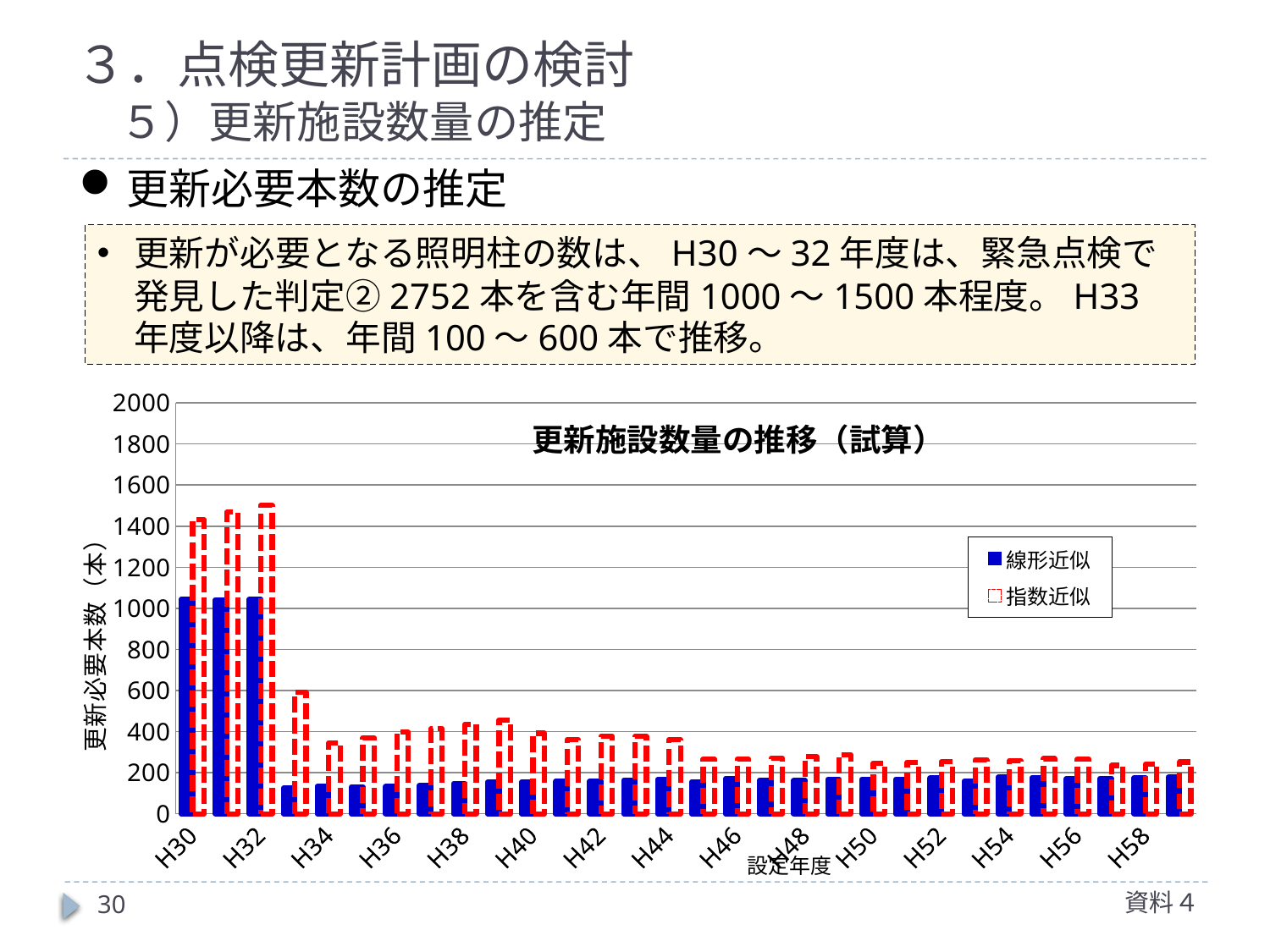
What is the title of the chart? 更新施設数量の推移（試算） Is the 指数近似 value for H32 greater or less than 1400? greater Do the 指数近似 values generally rise or fall from H33 to H59? fall How many series does the chart legend list? 2 Is the 指数近似 value for H30 greater or less than 1200? greater Which series is drawn with red dashed outlines? 指数近似 What kind of chart is shown on the slide? bar chart At H30, which series has the larger value, 線形近似 or 指数近似? 指数近似 Is the 線形近似 value for H34 greater or less than 200? less For the 指数近似 series, which year has the highest value? H32